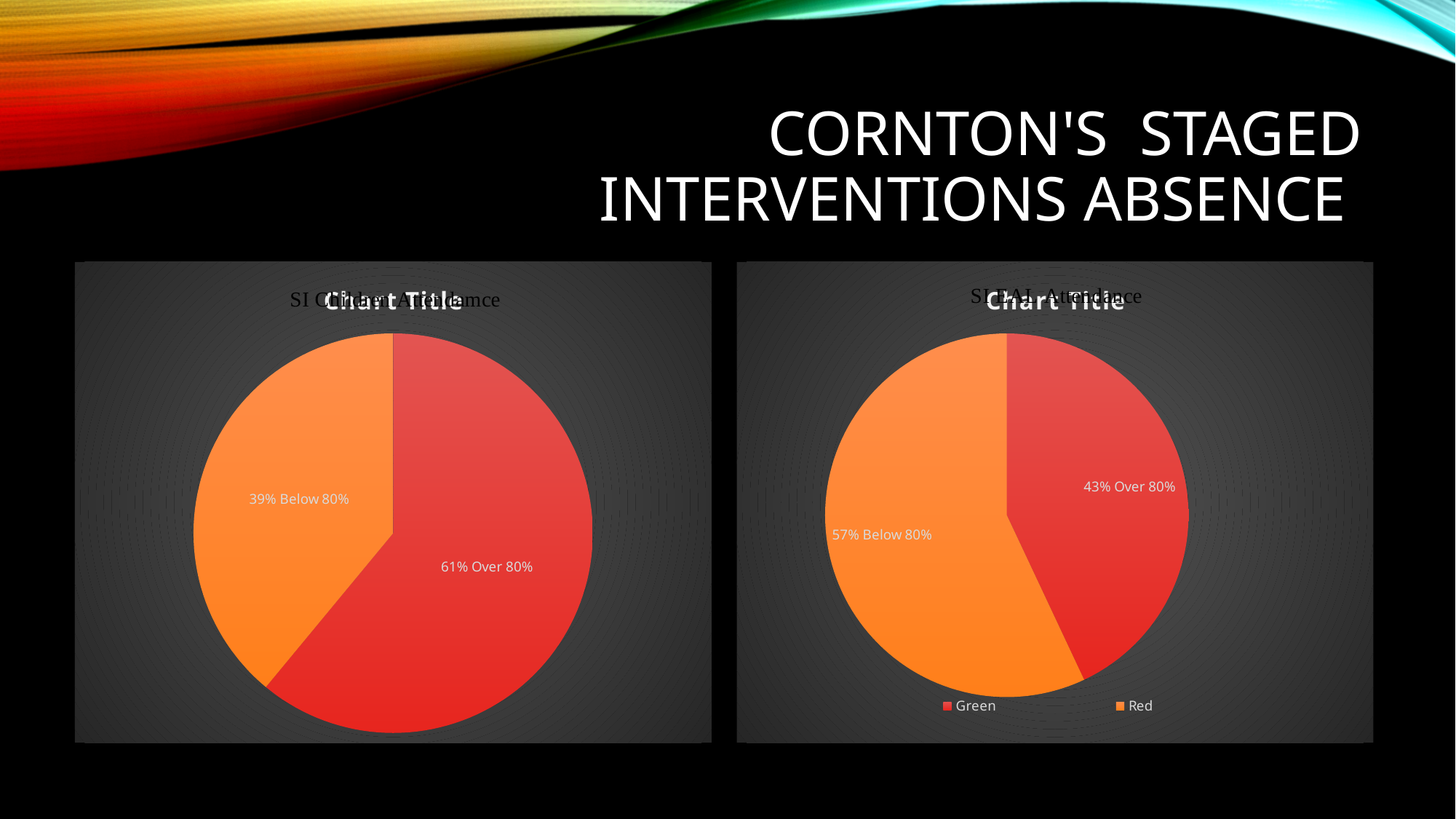
In the right pie chart, what share of the pie is labelled 'Below 80%'? 57% In the left pie chart, what is the difference between the 'Over 80%' share and the 'Below 80%' share? 22% In the right pie chart, what is the difference between the 'Below 80%' share and the 'Over 80%' share? 14% In the right pie chart, which slice is the smallest? Over 80% How many entries does the legend of the right pie chart list? 2 What kind of chart is the left chart on the slide? pie chart In the left pie chart, which slice is the largest? Over 80% In the left pie chart, what share of the pie is labelled 'Below 80%'? 39% Which is larger: the 'Over 80%' share in the left pie chart or the 'Over 80%' share in the right pie chart? the left pie chart In the right pie chart, what share of the pie is labelled 'Over 80%'? 43% How many slices does the right pie chart have? 2